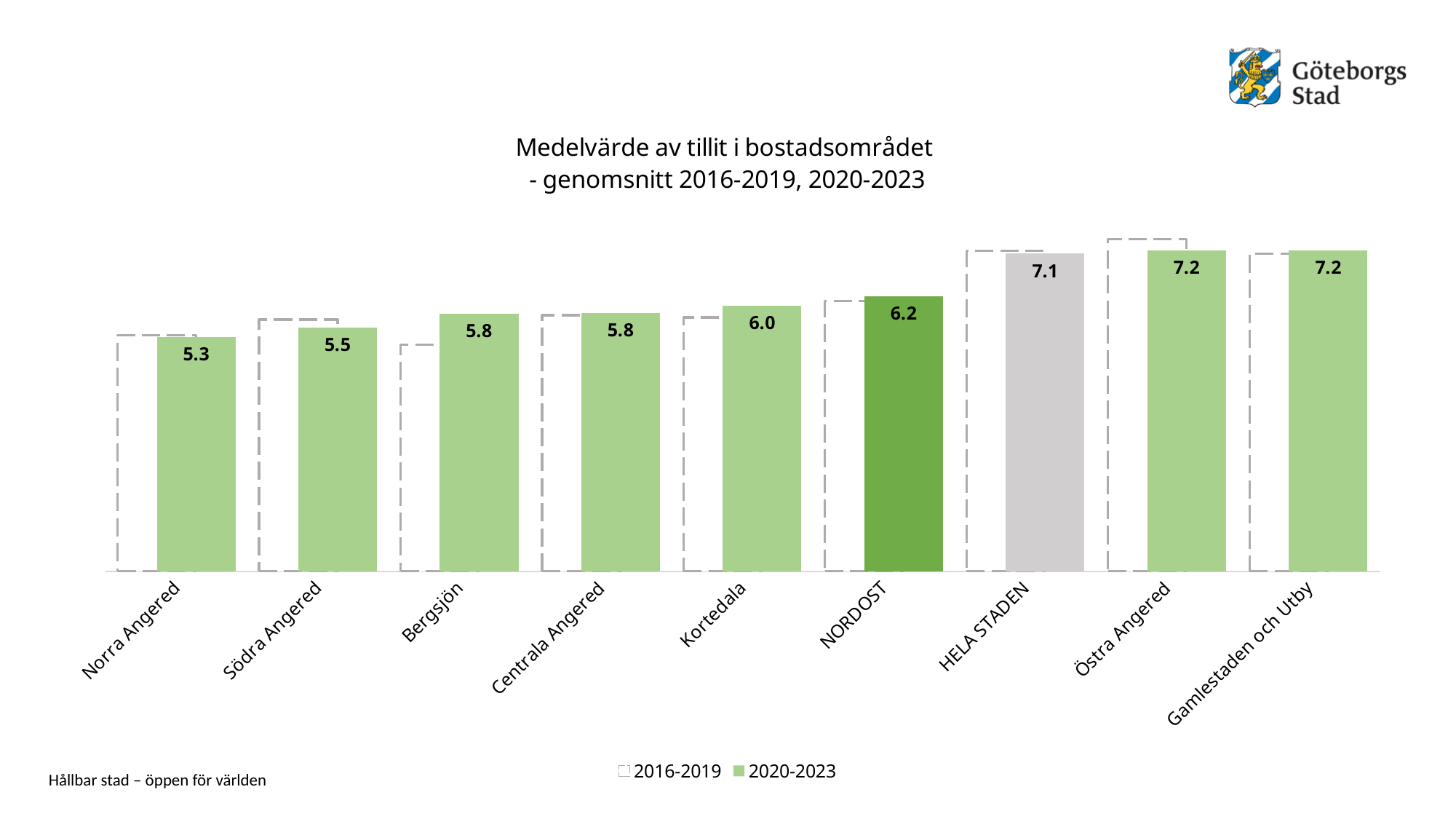
For Östra Angered, which period has the larger value, 2016-2019 or 2020-2023? 2016-2019 What is the 2020-2023 value for NORDOST? 6.2 Which category has the lowest 2020-2023 value? Norra Angered What is the 2020-2023 value for Kortedala? 6.0 What is the difference between the 2020-2023 values for Kortedala and Norra Angered? 0.7 What is the 2020-2023 value for HELA STADEN? 7.1 What is the 2020-2023 value for Norra Angered? 5.3 What is the difference between the 2020-2023 values for HELA STADEN and NORDOST? 0.9 How many series does the legend list? 2 Which has the larger 2020-2023 value, Bergsjön or Kortedala? Kortedala How many categories are shown on the x axis? 9 What kind of chart is shown on the slide? Bar chart